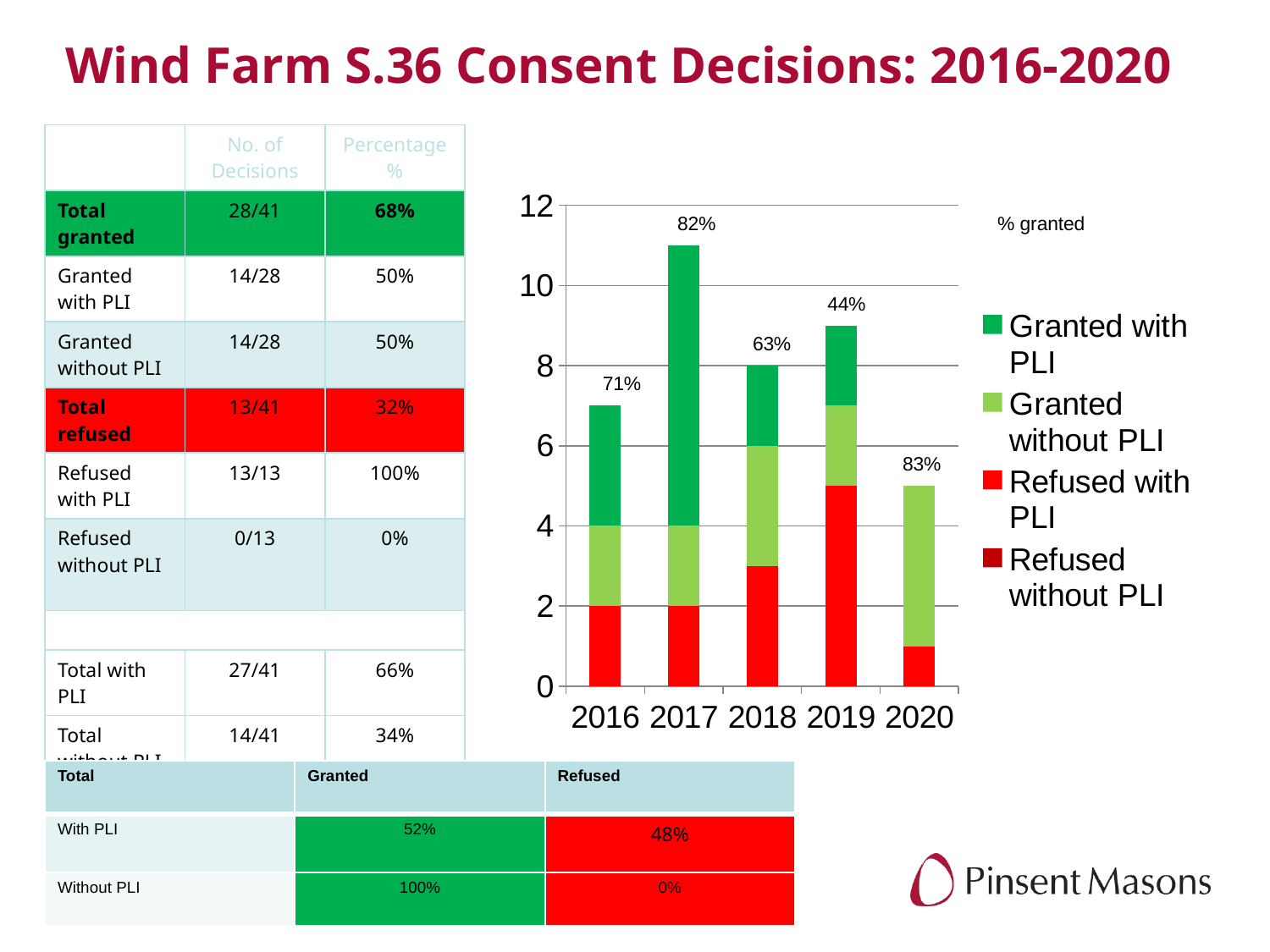
How many series does the chart legend list? 4 What is the % granted label shown above the 2019 bar? 44% Is the total height of the 2017 stacked bar greater or less than 10? greater What is the % granted label shown above the 2020 bar? 83% Which year has the highest % granted label on the chart? 2020 Which year has the lowest % granted label on the chart? 2019 Which year has the tallest stacked bar on the chart? 2017 What is the difference between the % granted labels for 2017 and 2019? 38 percentage points Is the total height of the 2020 stacked bar greater or less than 6? less Which year has the higher % granted label, 2016 or 2018? 2016 How many years are shown on the x axis of the chart? 5 What is the % granted label shown above the 2017 bar? 82%